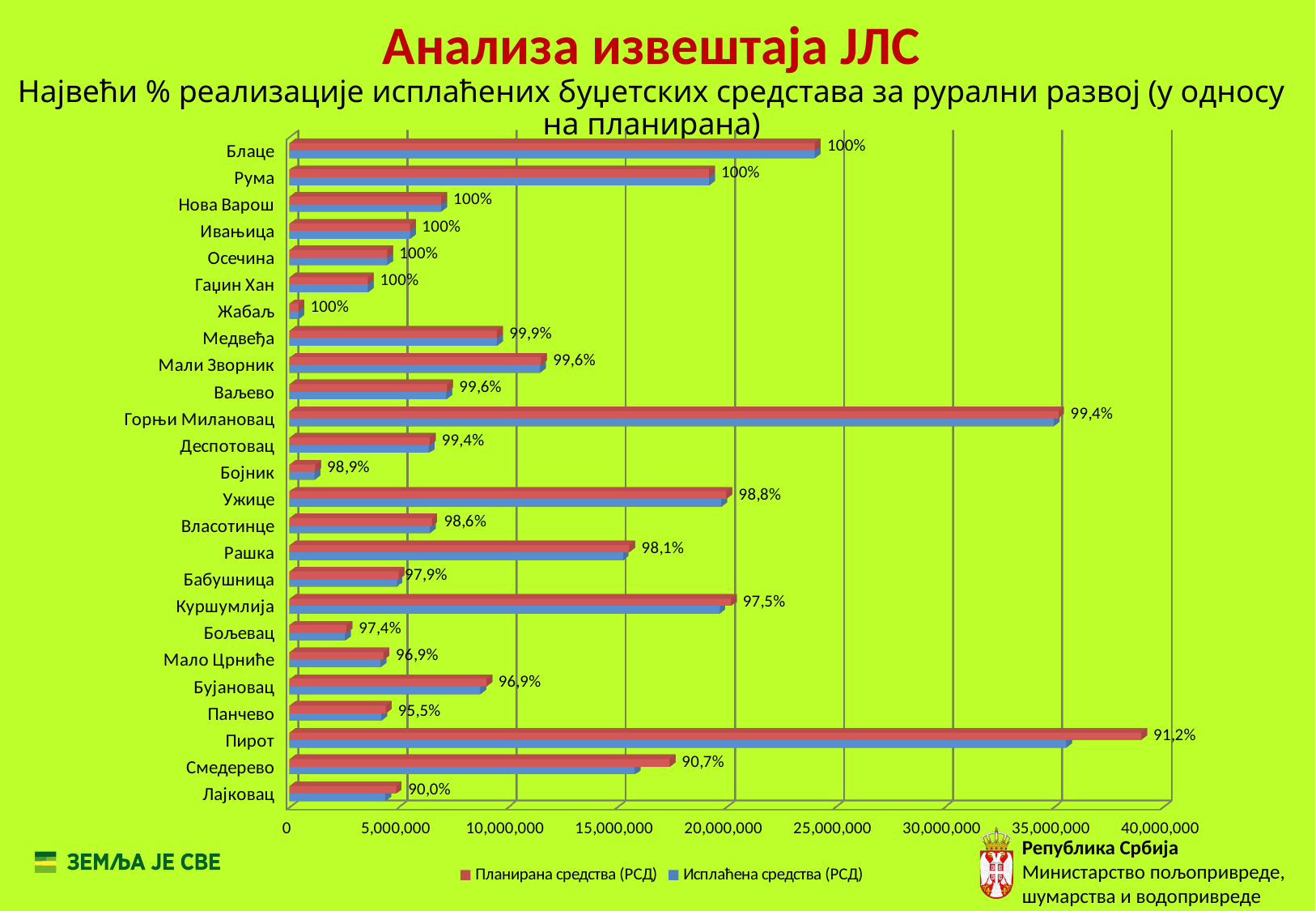
Is the Планирана средства (РСД) value for Бојник greater or less than 5,000,000? less Is the Планирана средства (РСД) value for Пирот greater or less than 35,000,000? greater Which has the higher percentage label, Смедерево or Панчево? Панчево Which municipality has the longest bar for Планирана средства (РСД)? Пирот Which municipality has the lowest percentage label on the chart? Лајковац What percentage is shown as the data label for Пирот? 91,2% What is the difference between the percentage labels for Пирот and Лајковац? 1,2 percentage points What percentage is shown as the data label for Куршумлија? 97,5% How many series does the legend list? 2 What percentage is shown as the data label for Лајковац? 90,0% What type of chart is shown on the slide? Bar chart How many municipalities are shown on the chart? 25